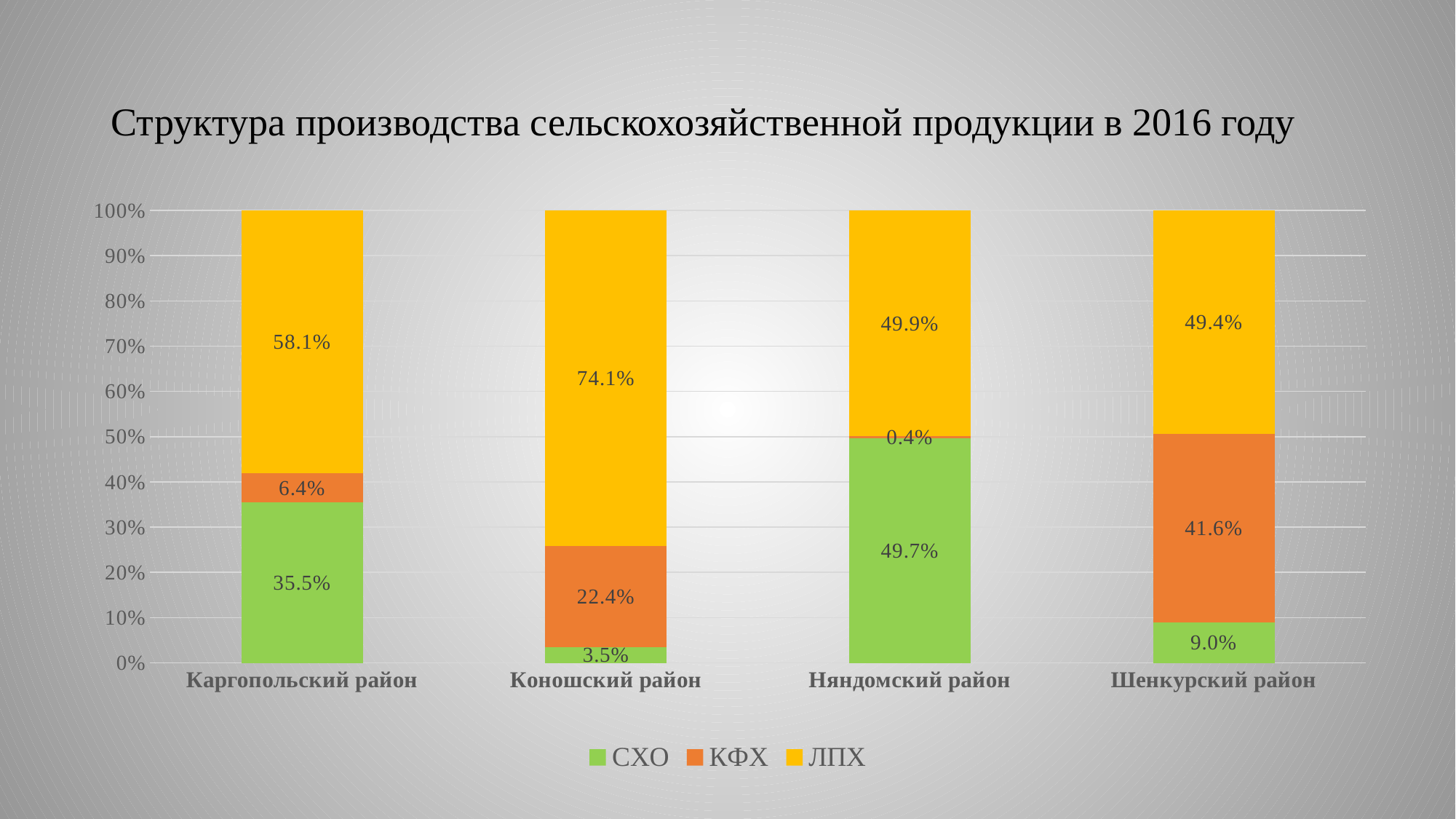
What kind of chart is shown on the slide? Stacked bar chart Which district has the lowest СХО share? Коношский район What is the КФХ share for Шенкурский район? 41.6% How many series does the legend list? 3 What is the ЛПХ share for Коношский район? 74.1% What is the КФХ share for Каргопольский район? 6.4% Which is larger for Шенкурский район: the КФХ share or the СХО share? КФХ How many districts are shown on the x axis? 4 Which district has the lowest КФХ share? Няндомский район What is the СХО share for Няндомский район? 49.7% What is the difference between the ЛПХ share and the СХО share for Каргопольский район? 22.6% Which district has the highest ЛПХ share? Коношский район